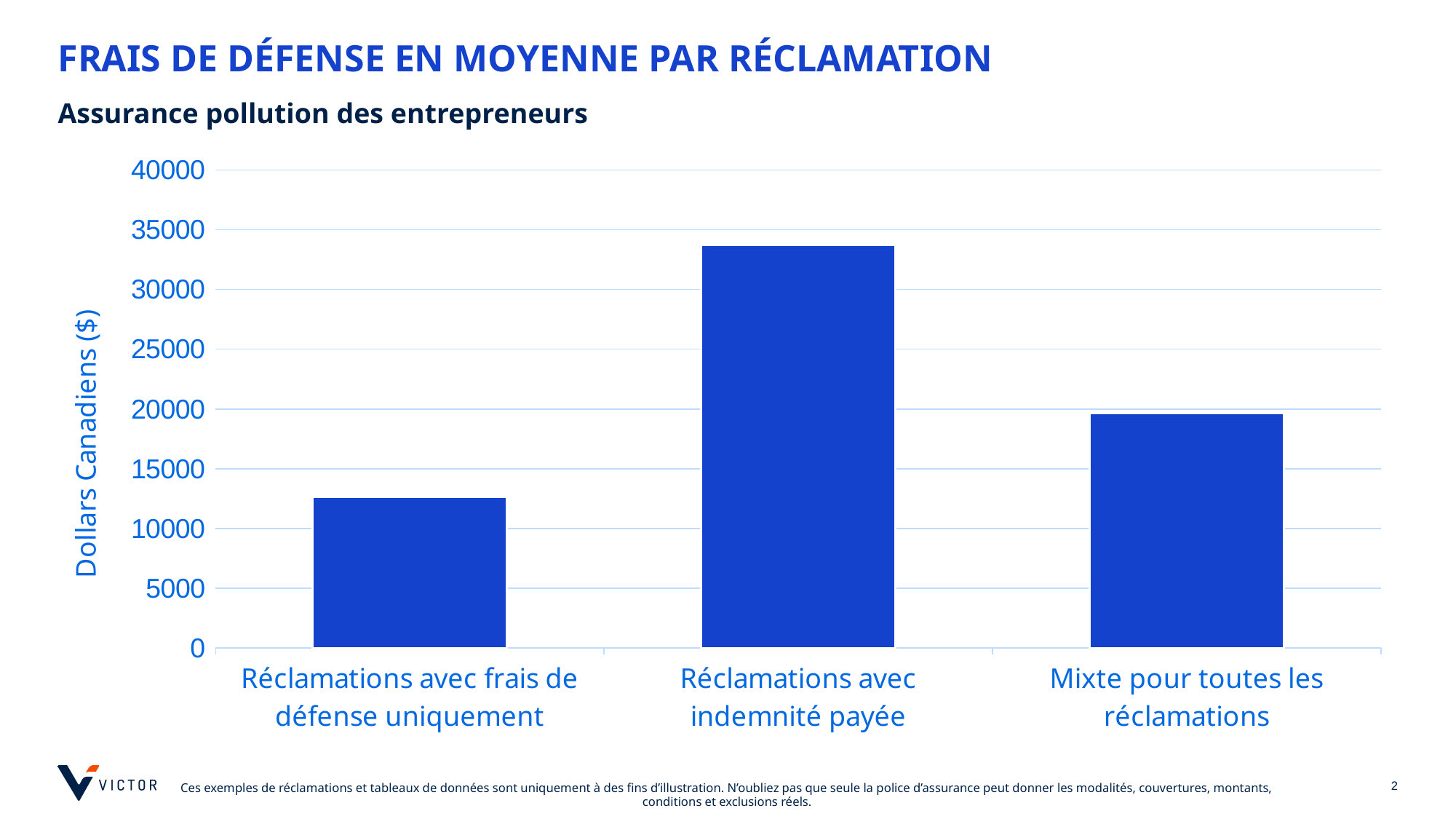
Is the value for 'Réclamations avec indemnité payée' greater or less than 30000? greater Which is larger: the value for 'Mixte pour toutes les réclamations' or the value for 'Réclamations avec frais de défense uniquement'? Mixte pour toutes les réclamations Which category has the lowest average defence cost? Réclamations avec frais de défense uniquement Is the value for 'Réclamations avec indemnité payée' greater or less than 35000? less What is the title of the slide containing the chart? FRAIS DE DÉFENSE EN MOYENNE PAR RÉCLAMATION How many categories are plotted on the chart? 3 Is the value for 'Réclamations avec frais de défense uniquement' greater or less than 10000? greater Which category has the highest average defence cost? Réclamations avec indemnité payée What kind of chart is shown on the slide? bar chart What is the label of the vertical axis? Dollars Canadiens ($)